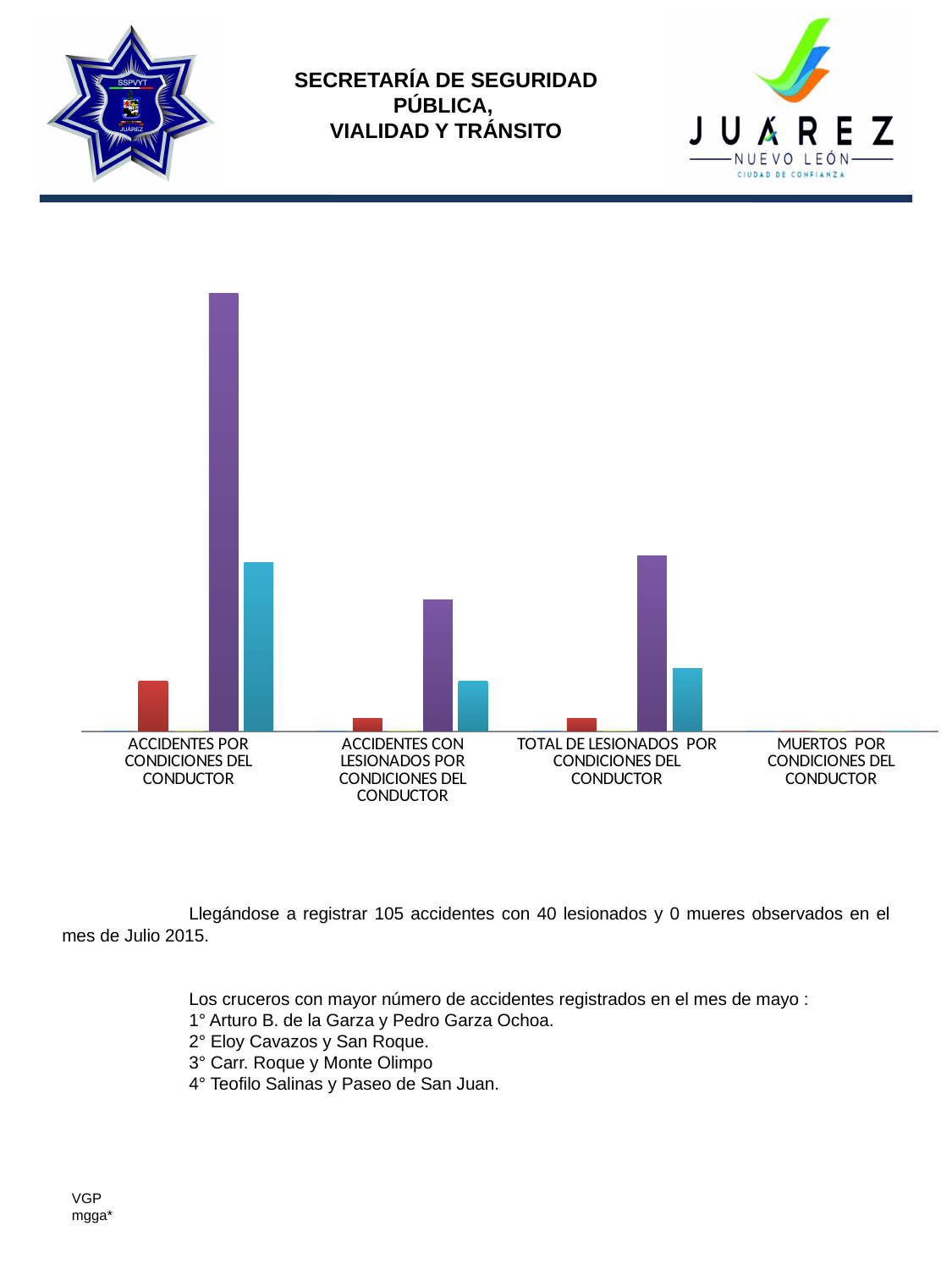
Within the ACCIDENTES POR CONDICIONES DEL CONDUCTOR category, is the red bar or the teal bar taller? teal bar Is the purple bar taller for ACCIDENTES CON LESIONADOS POR CONDICIONES DEL CONDUCTOR or for TOTAL DE LESIONADOS POR CONDICIONES DEL CONDUCTOR? TOTAL DE LESIONADOS POR CONDICIONES DEL CONDUCTOR Which category shows no visible bars at all? MUERTOS POR CONDICIONES DEL CONDUCTOR Which category has the tallest bar in the chart? ACCIDENTES POR CONDICIONES DEL CONDUCTOR How many bars are drawn for the ACCIDENTES POR CONDICIONES DEL CONDUCTOR category? 3 Within each category that has bars, which colour of bar is the tallest? purple How many categories are shown along the x axis of the chart? 4 Is the purple bar taller for ACCIDENTES POR CONDICIONES DEL CONDUCTOR or for TOTAL DE LESIONADOS POR CONDICIONES DEL CONDUCTOR? ACCIDENTES POR CONDICIONES DEL CONDUCTOR Does the chart display a legend? No What kind of chart is shown on the slide? bar chart